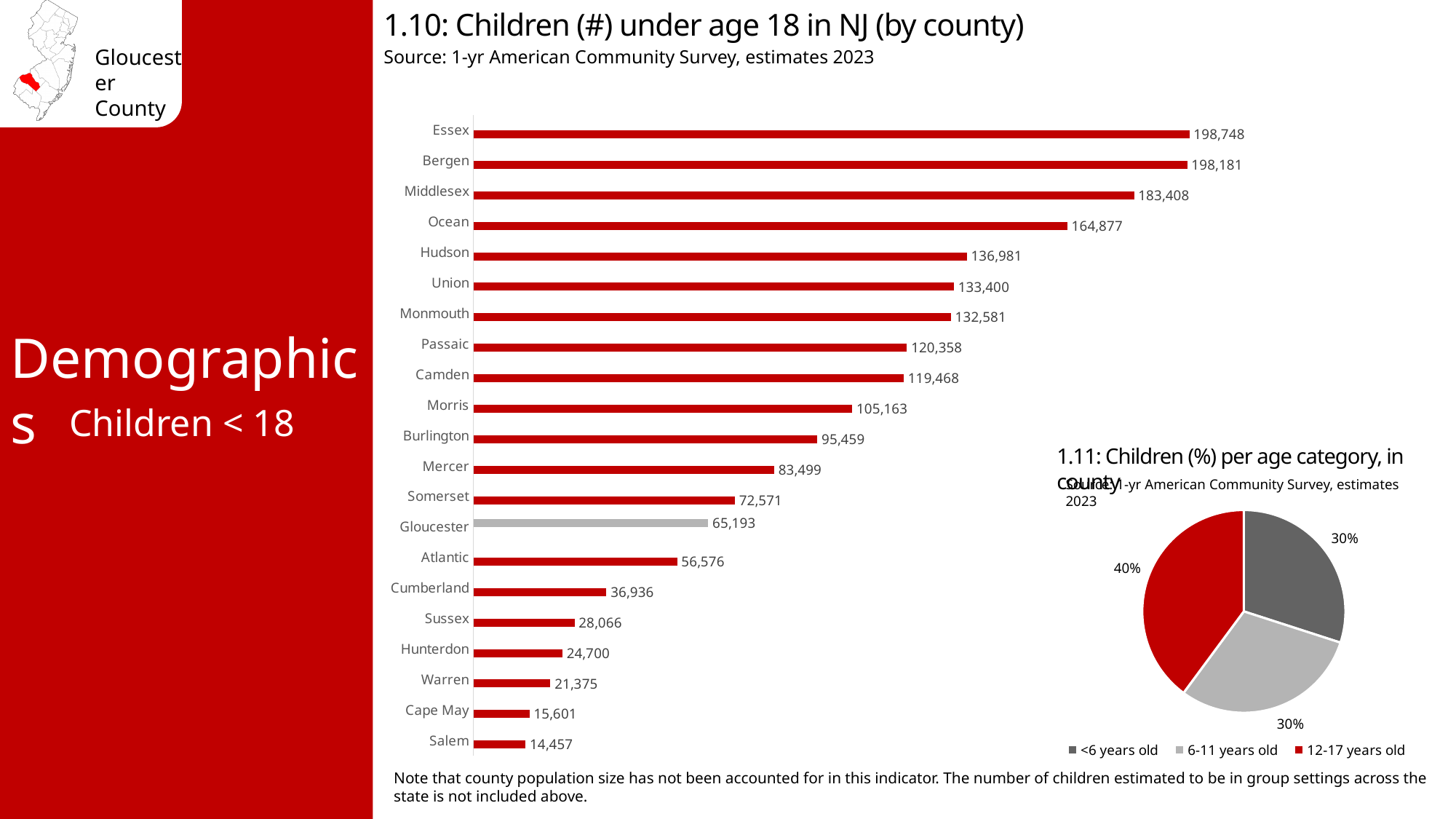
In chart 1.10, which county has the highest number of children under 18? Essex In chart 1.10, which has more children under 18, Passaic or Morris? Passaic In chart 1.10, which county's bar is coloured grey instead of red? Gloucester How many age categories does the legend of chart 1.11 list? 3 In chart 1.10, how many children under age 18 are in Gloucester County? 65,193 What kind of chart is chart 1.10? Bar chart In chart 1.11, what share of children are 12-17 years old? 40% In chart 1.11, what percentage of children are under 6 years old? 30% In chart 1.10, what is the value for Camden? 119,468 In chart 1.10, what is the difference between Somerset and Gloucester? 7,378 In chart 1.10, which county has the lowest number of children under 18? Salem How many counties are shown in chart 1.10? 21